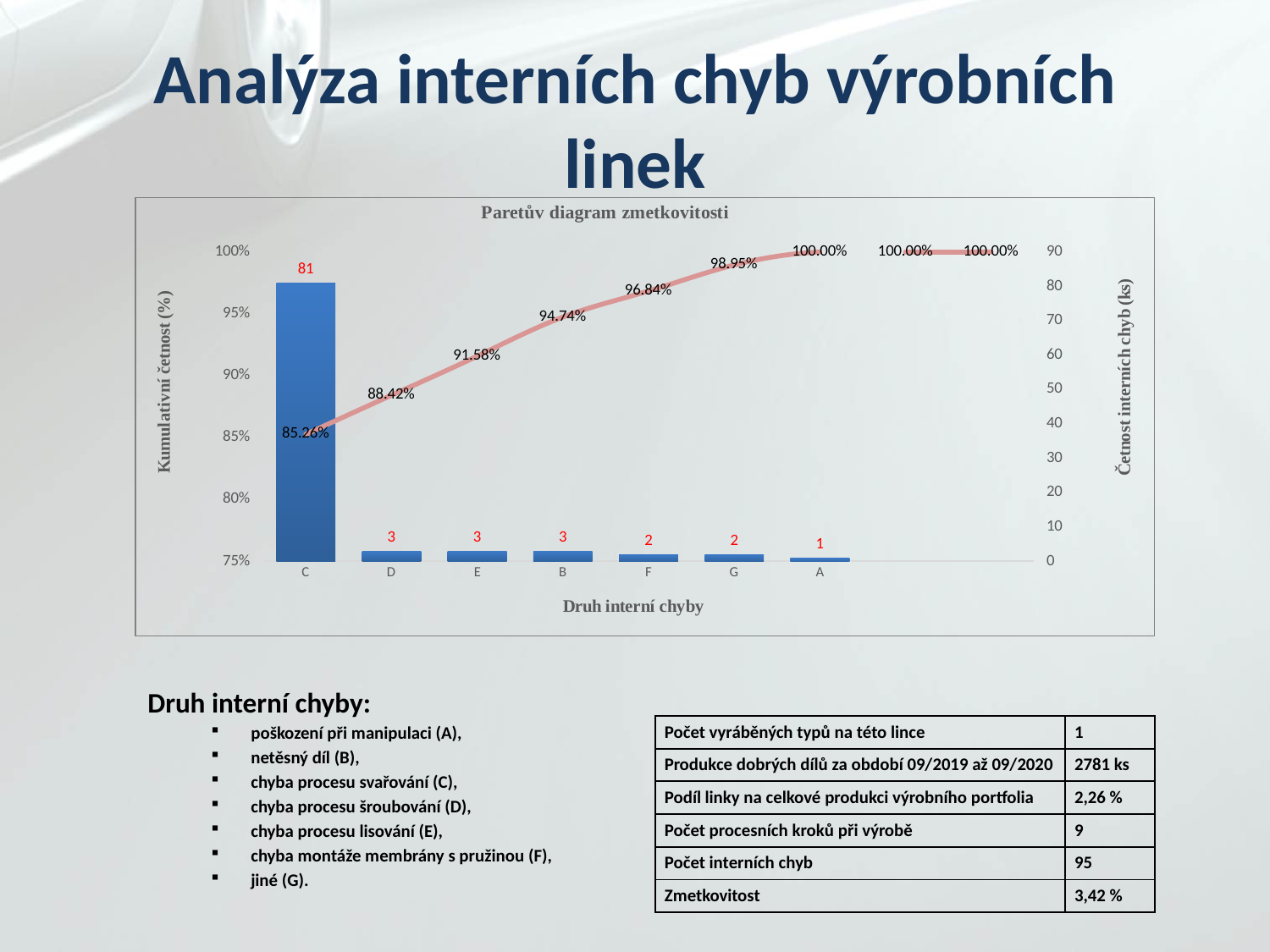
What is the title of the chart? Paretův diagram zmetkovitosti Which has a larger bar value, D or F? D What kind of chart is this? A bar chart combined with a line chart What is the value of the bar for category C? 81 Does the cumulative percentage line rise or fall from C to A? Rises What is the cumulative percentage shown at category E? 91.58% Which category has the lowest bar? A What is the difference between the bar values for C and D? 78 How many categories are shown on the x axis? 7 What is the value of the bar for category A? 1 Which category has the highest bar? C What is the cumulative percentage shown at category G? 98.95%